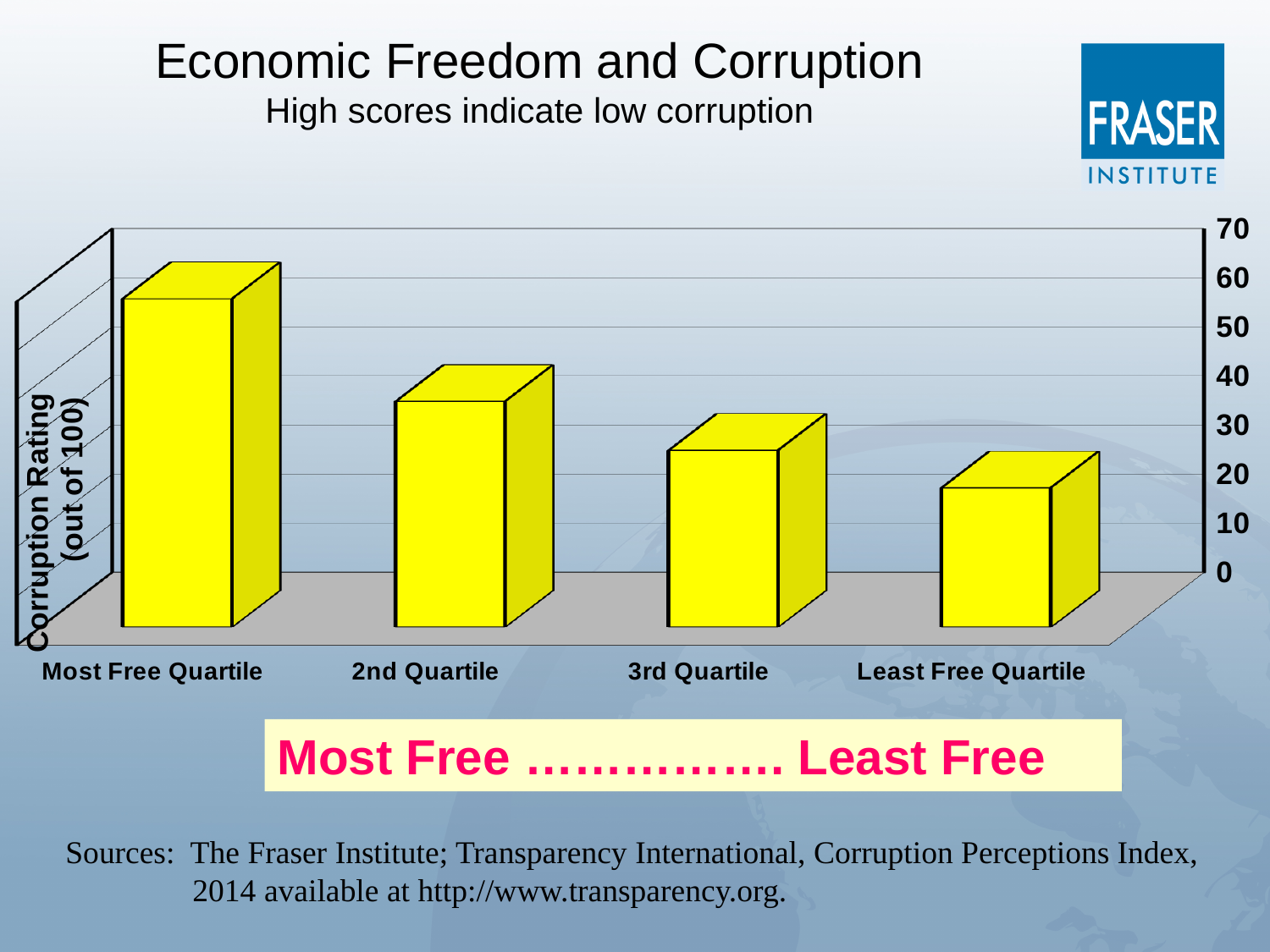
Is the corruption rating for the Most Free Quartile greater or less than 50? greater Do the corruption ratings rise or fall moving from the Most Free Quartile to the Least Free Quartile? fall Which has a higher corruption rating, the 2nd Quartile or the 3rd Quartile? 2nd Quartile Which quartile has the lowest corruption rating? Least Free Quartile What is the label on the vertical axis of the chart? Corruption Rating (out of 100) What is the title of the chart on the slide? Economic Freedom and Corruption Which quartile has the highest corruption rating? Most Free Quartile What kind of chart is shown on the slide? bar chart How many quartile categories are plotted on the chart? 4